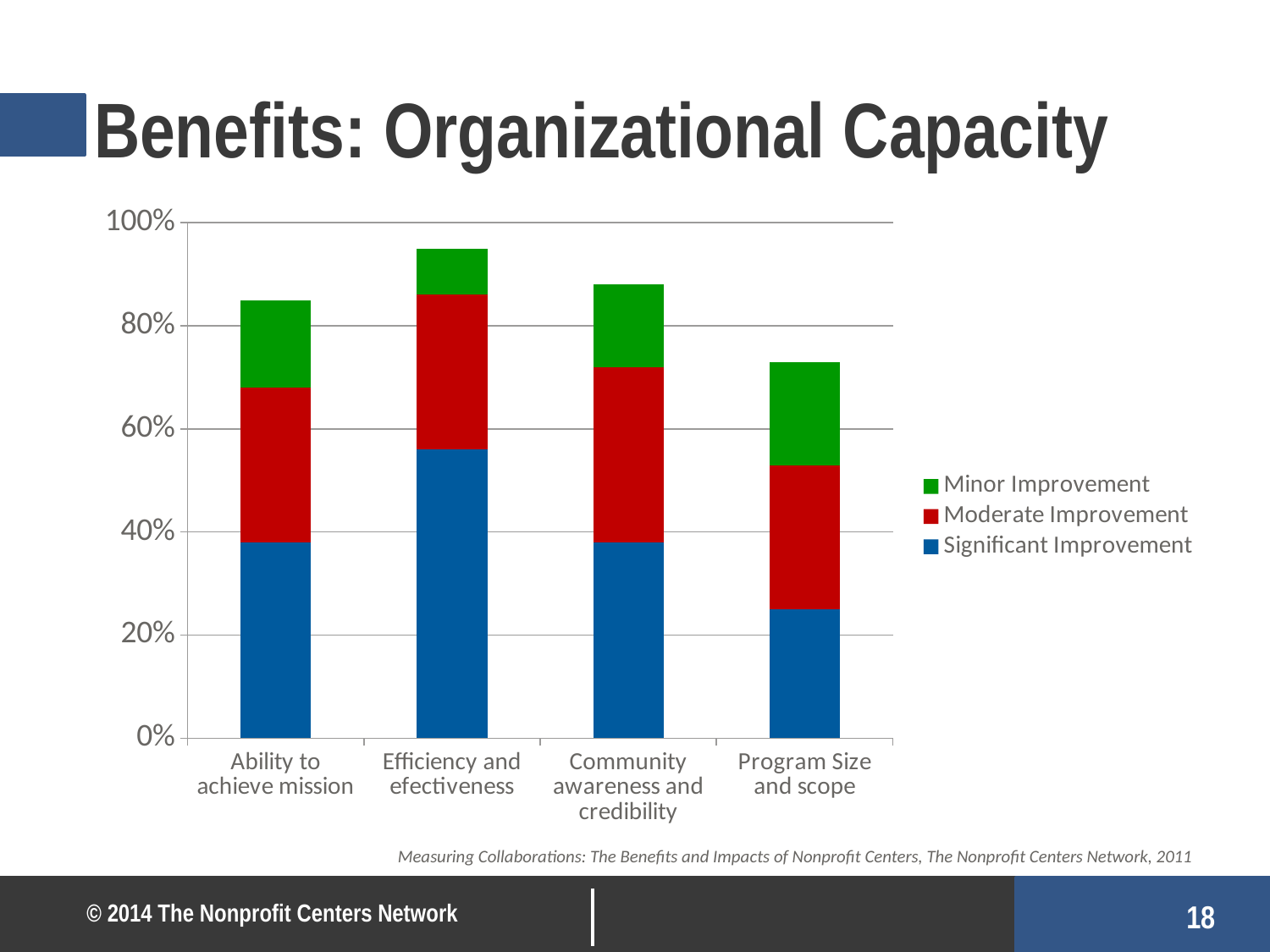
Which category has the smallest Significant Improvement segment? Program Size and scope Which is larger: the total stacked bar for Community awareness and credibility or for Program Size and scope? Community awareness and credibility What kind of chart is shown on the slide? Stacked bar chart Is the total stacked bar for Program Size and scope greater or less than 80%? less Is the Significant Improvement value for Program Size and scope greater or less than 40%? less How many series does the legend list? 3 Which colour represents Moderate Improvement in the legend? Red Is the Significant Improvement value for Efficiency and efectiveness greater or less than 40%? greater Which category has the shortest stacked bar overall? Program Size and scope Which category has the tallest stacked bar overall? Efficiency and efectiveness Which category has the largest Significant Improvement segment? Efficiency and efectiveness How many categories are shown on the x axis of the chart? 4